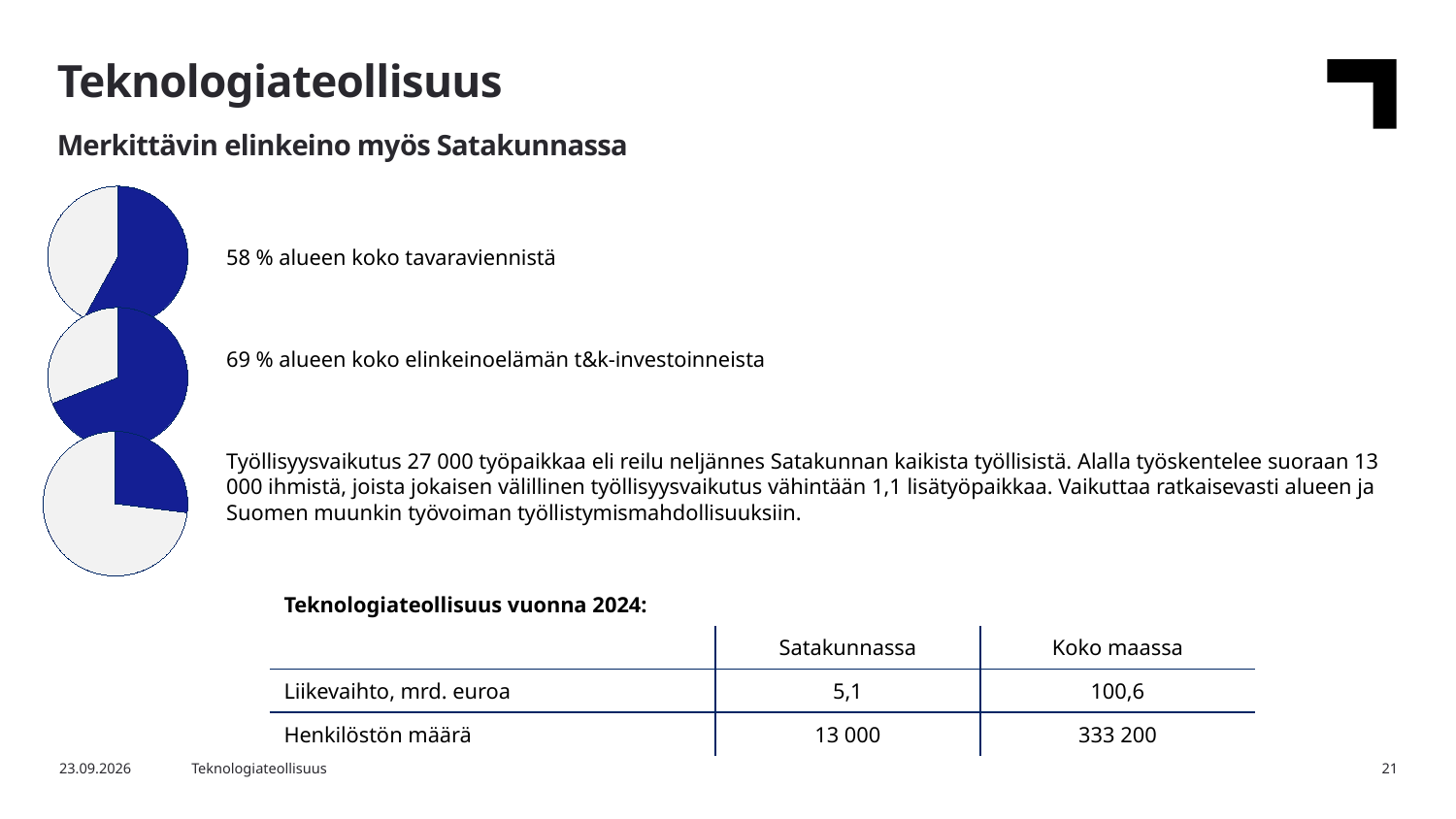
Is the blue slice in the bottom pie chart greater or less than 50% of the pie? less Which has a larger blue slice, the top pie chart or the middle pie chart? Middle pie chart Which pie chart has the largest blue slice: the top, middle or bottom one? Middle According to the text next to the middle pie chart, what share of the region's business R&D investments does the blue slice represent? 69 % What kind of charts are shown on the left side of the slide? Pie charts How many pie charts are on the slide? 3 Which pie chart has the smallest blue slice: the top, middle or bottom one? Bottom Is the blue slice in the middle pie chart greater or less than 50% of the pie? greater According to the text next to the top pie chart, what share of the region's total goods exports does the blue slice represent? 58 % What is the difference in percentage points between the shares shown for the middle pie chart (69 %) and the top pie chart (58 %)? 11 percentage points How many slices does each pie chart have? 2 What two colours are used for the slices in the pie charts? Blue and light grey